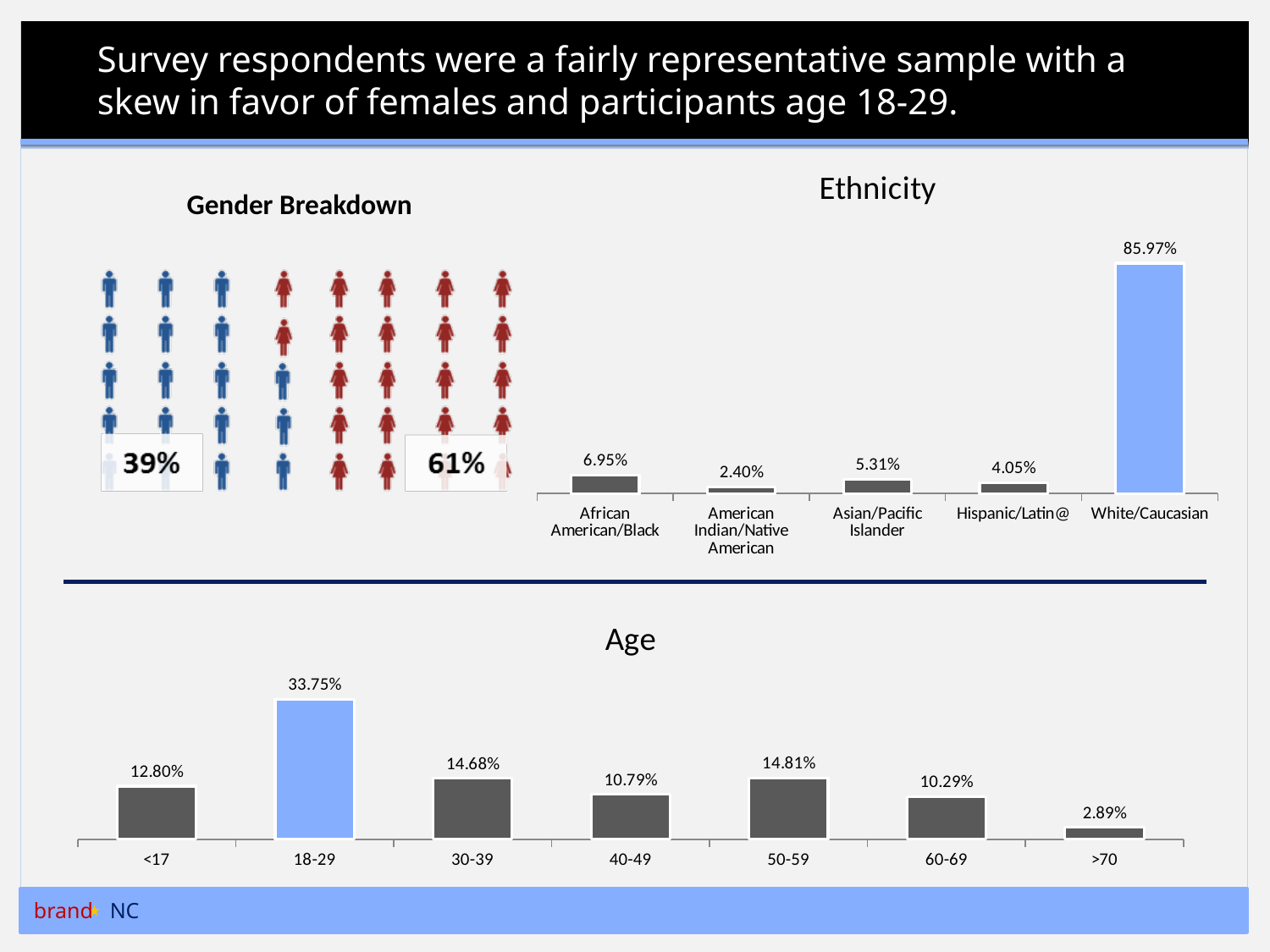
In the Gender Breakdown chart, what percentage of respondents were female? 61% In the Ethnicity chart, which category has the lowest value? American Indian/Native American In the Age chart, which is larger, the value for <17 or the value for 40-49? <17 In the Ethnicity chart, how many ethnicity categories are shown? 5 In the Age chart, what is the value for the >70 group? 2.89% In the Age chart, what is the difference between the 18-29 group and the 50-59 group? 18.94% In the Ethnicity chart, what is the difference between White/Caucasian and African American/Black? 79.02% In the Age chart, what is the value for the 18-29 group? 33.75% In the Ethnicity chart, what is the value for American Indian/Native American? 2.40% In the Age chart, which age group has the highest value? 18-29 In the Age chart, how many age groups are shown? 7 In the Ethnicity chart, what is the value for White/Caucasian? 85.97%